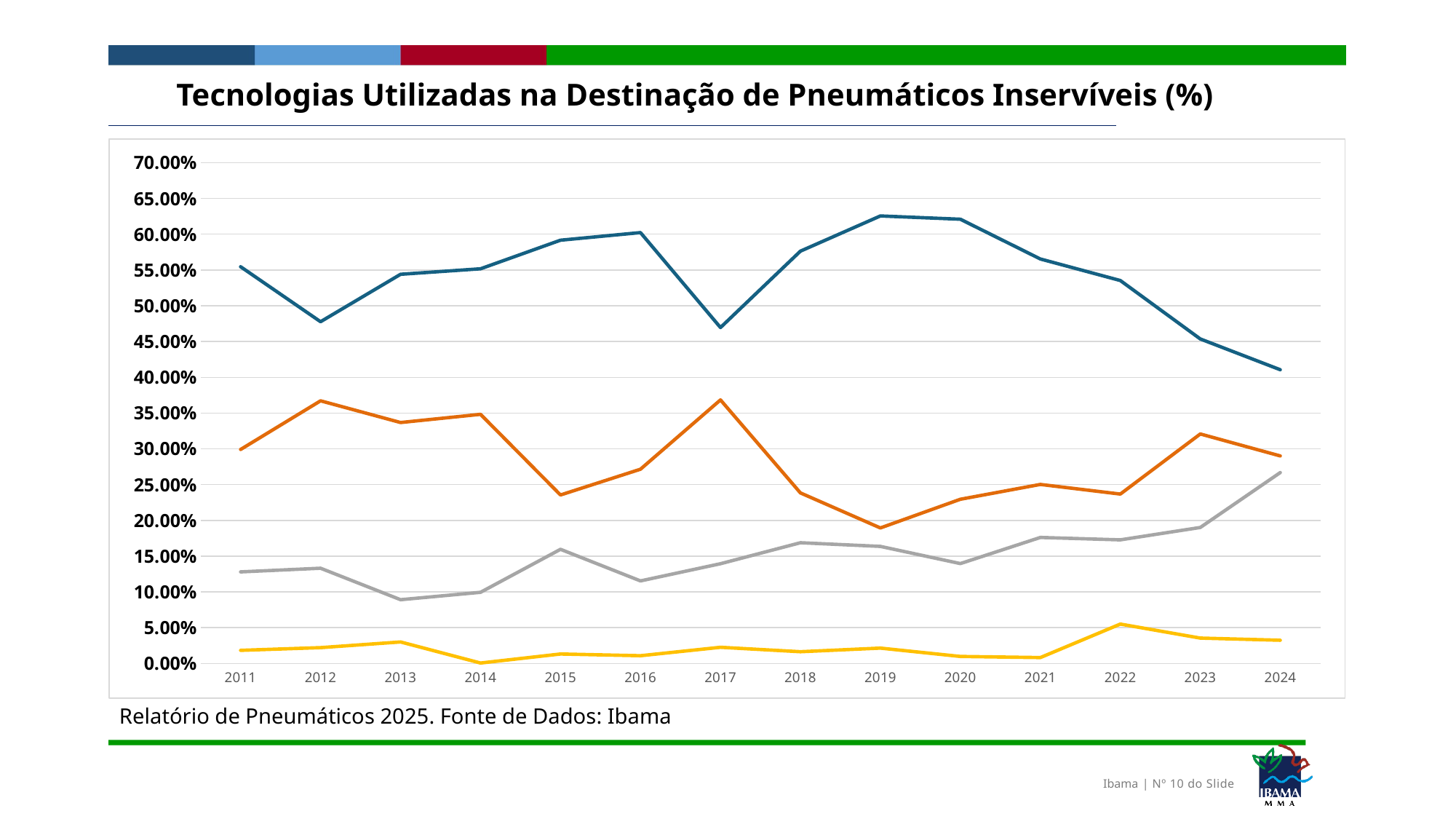
How many lines are plotted on the chart? 4 Is the value of the dark blue line in 2024 greater or less than 45.00%? less Does the dark blue line rise or fall from 2019 to 2024? fall What is the title of the chart? Tecnologias Utilizadas na Destinação de Pneumáticos Inservíveis (%) In which year does the grey line reach its highest value? 2024 Which is larger for the dark blue line: the value in 2016 or the value in 2017? 2016 Is the value of the grey line in 2024 greater or less than 25.00%? greater Is the value of the orange line in 2019 greater or less than 20.00%? less How many years are shown along the x axis of the chart? 14 In which year does the orange line reach its lowest value? 2019 What kind of chart is shown on the slide? line chart